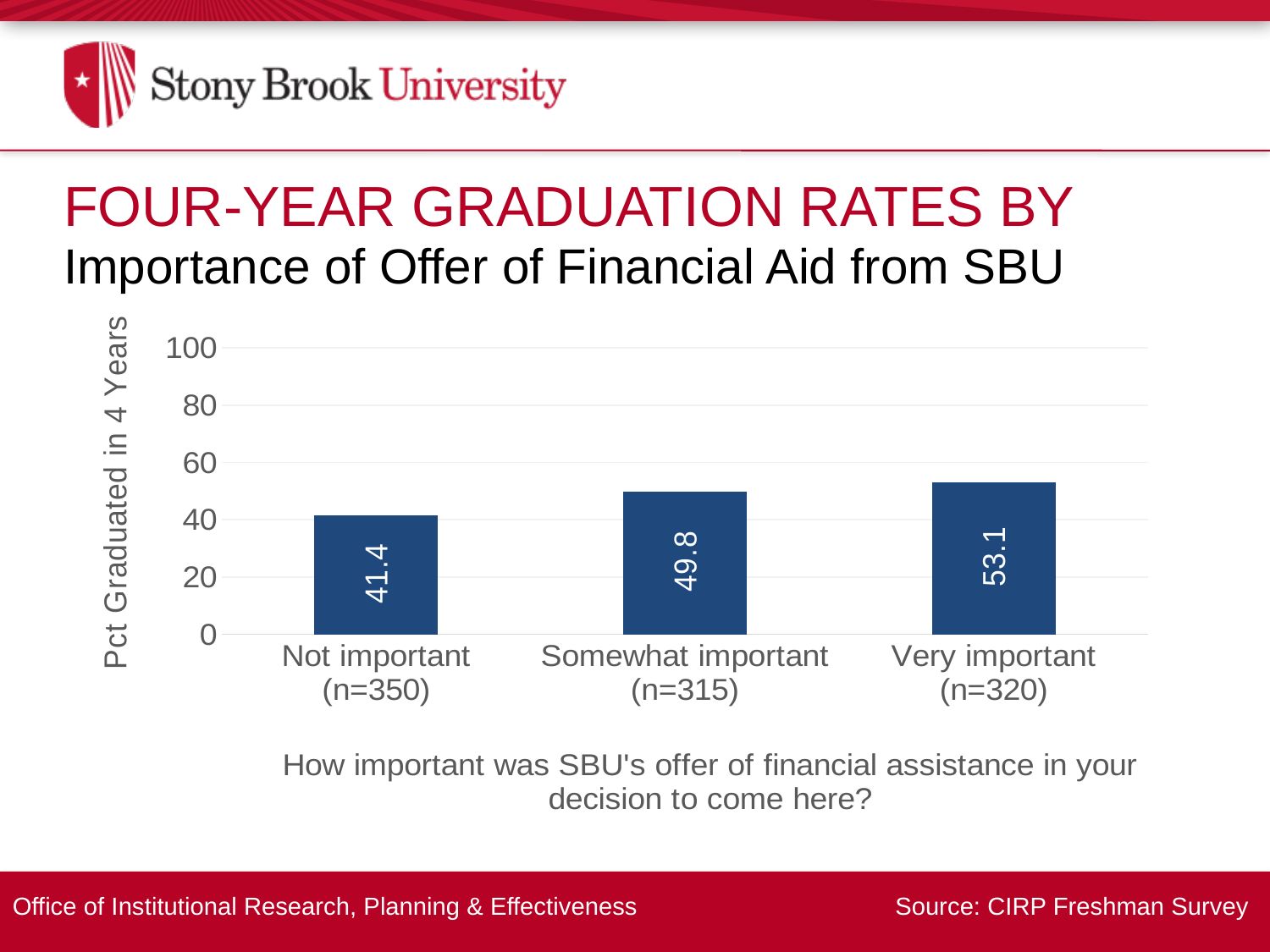
What is the four-year graduation rate for students who said the offer of financial aid was Not important? 41.4 How many categories are shown on the x axis of the chart? 3 Which group has the lowest four-year graduation rate? Not important Which group has a higher four-year graduation rate, Somewhat important or Very important? Very important What kind of chart is shown on the slide? bar chart Is the four-year graduation rate for the Not important group greater or less than 60? less Do the four-year graduation rates rise or fall moving from Not important to Very important along the x axis? rise What is the difference in four-year graduation rate between the Very important and Not important groups? 11.7 What is the four-year graduation rate for the Somewhat important group? 49.8 What is the difference in four-year graduation rate between the Somewhat important and Not important groups? 8.4 What is the four-year graduation rate for the Very important group? 53.1 Which group has the highest four-year graduation rate? Very important